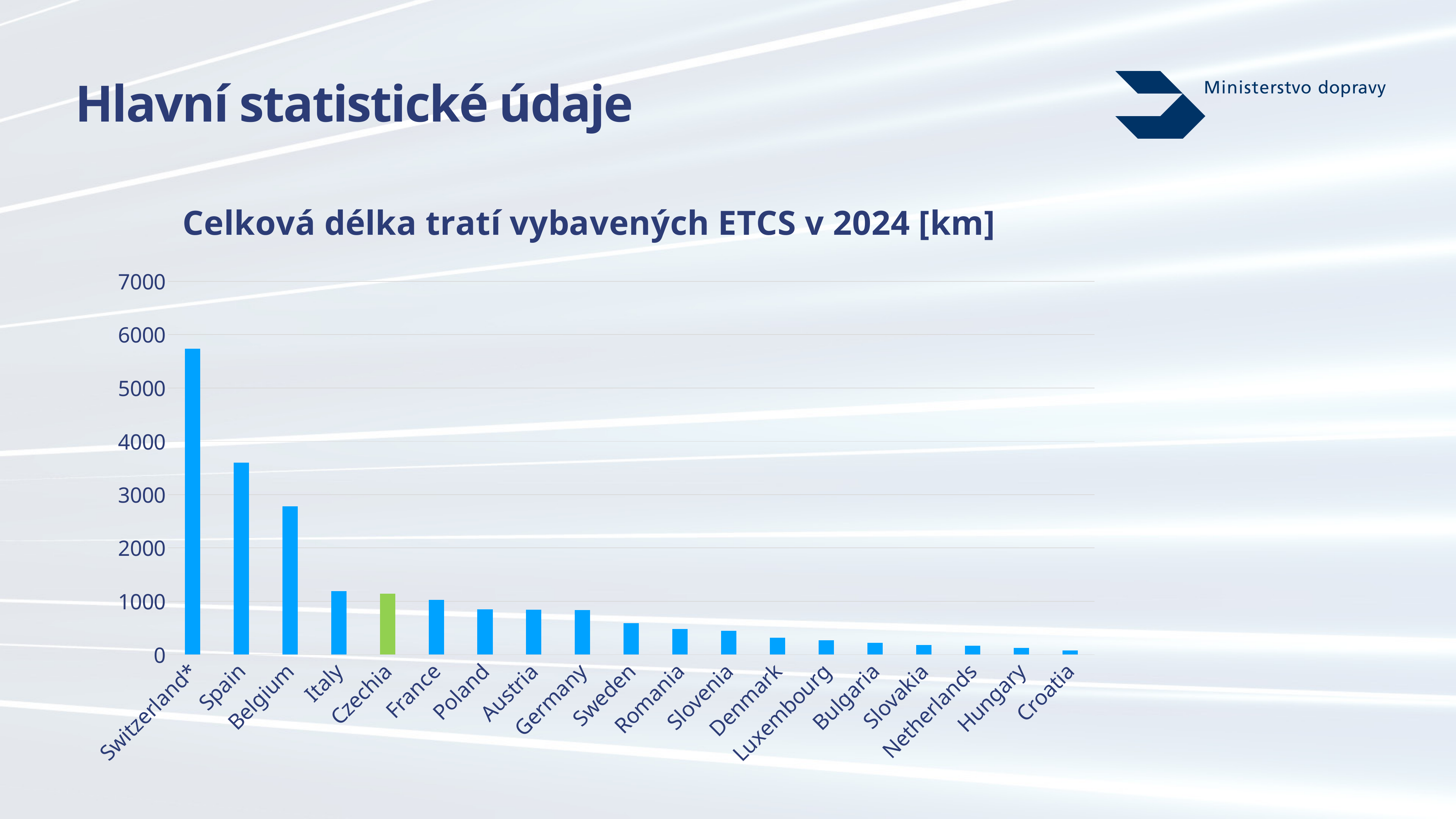
How many countries are shown on the x axis of the chart? 19 Do the values rise or fall from left to right along the x axis? fall What kind of chart is shown on the slide? bar chart Is the value for Czechia greater or less than 1000? greater Which country's bar is coloured green instead of blue? Czechia Is the value for Sweden greater or less than 1000? less Which country has the lowest value in the chart? Croatia Which has a larger value, Spain or Belgium? Spain Is the value for Belgium greater or less than 3000? less Which country has the highest value in the chart? Switzerland*